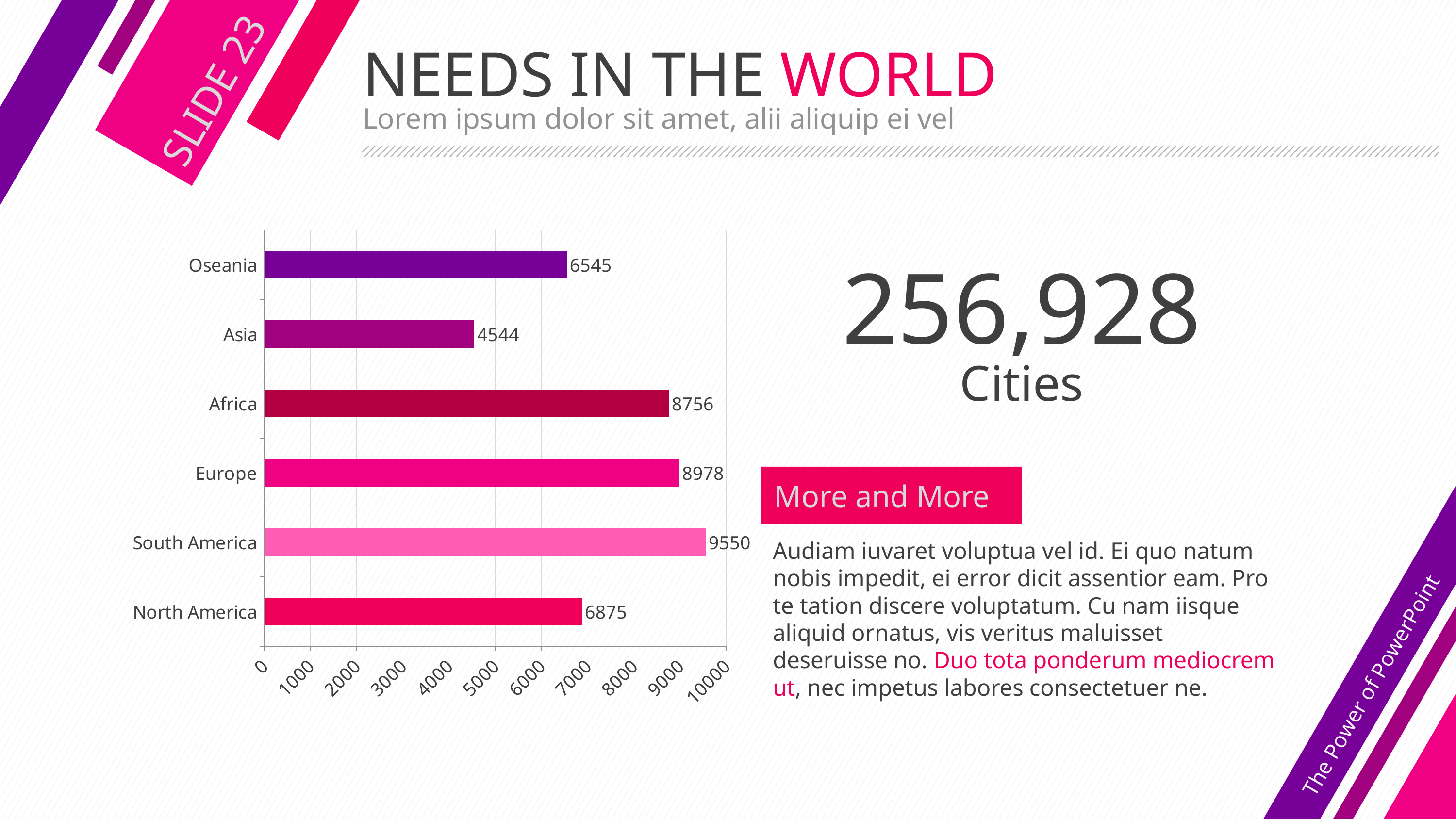
Which category has the highest value? South America Which is larger, the value for Oseania or the value for North America? North America What kind of chart is shown on the slide? bar chart What is the maximum value shown on the horizontal axis? 10000 What is the difference between the values for Europe and Africa? 222 Which category has the lowest value? Asia What is the value for North America? 6875 What is the difference between the values for Oseania and Asia? 2001 How many categories are shown in the chart? 6 What is the value for Asia? 4544 What is the value for Africa? 8756 Is the value for Europe greater or less than 8000? greater